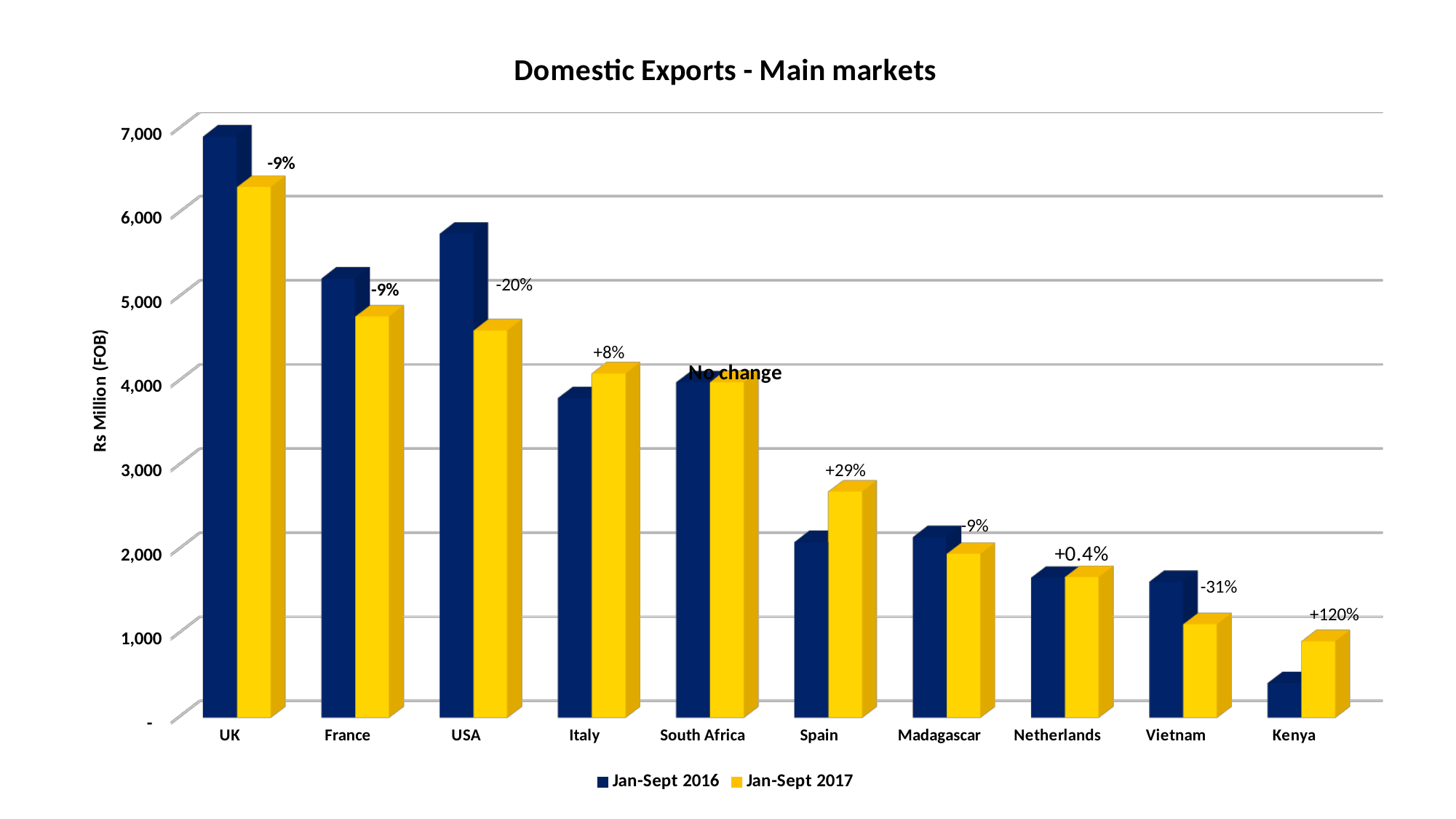
How many markets (categories) are shown on the x axis? 10 What percentage change is labelled for Kenya? +120% Which market has the lowest Jan-Sept 2017 value? Kenya For Italy, which is larger: the Jan-Sept 2016 value or the Jan-Sept 2017 value? Jan-Sept 2017 What label is shown above the South Africa bars? No change What kind of chart is shown on the slide? Bar chart How many series does the legend list? 2 What percentage change is labelled for the USA? -20% Is the Jan-Sept 2016 value for Kenya greater or less than 1,000? less What percentage change is labelled for the Netherlands? +0.4% Which market has the highest Jan-Sept 2016 value? UK Is the Jan-Sept 2016 value for the UK greater or less than 6,000? greater